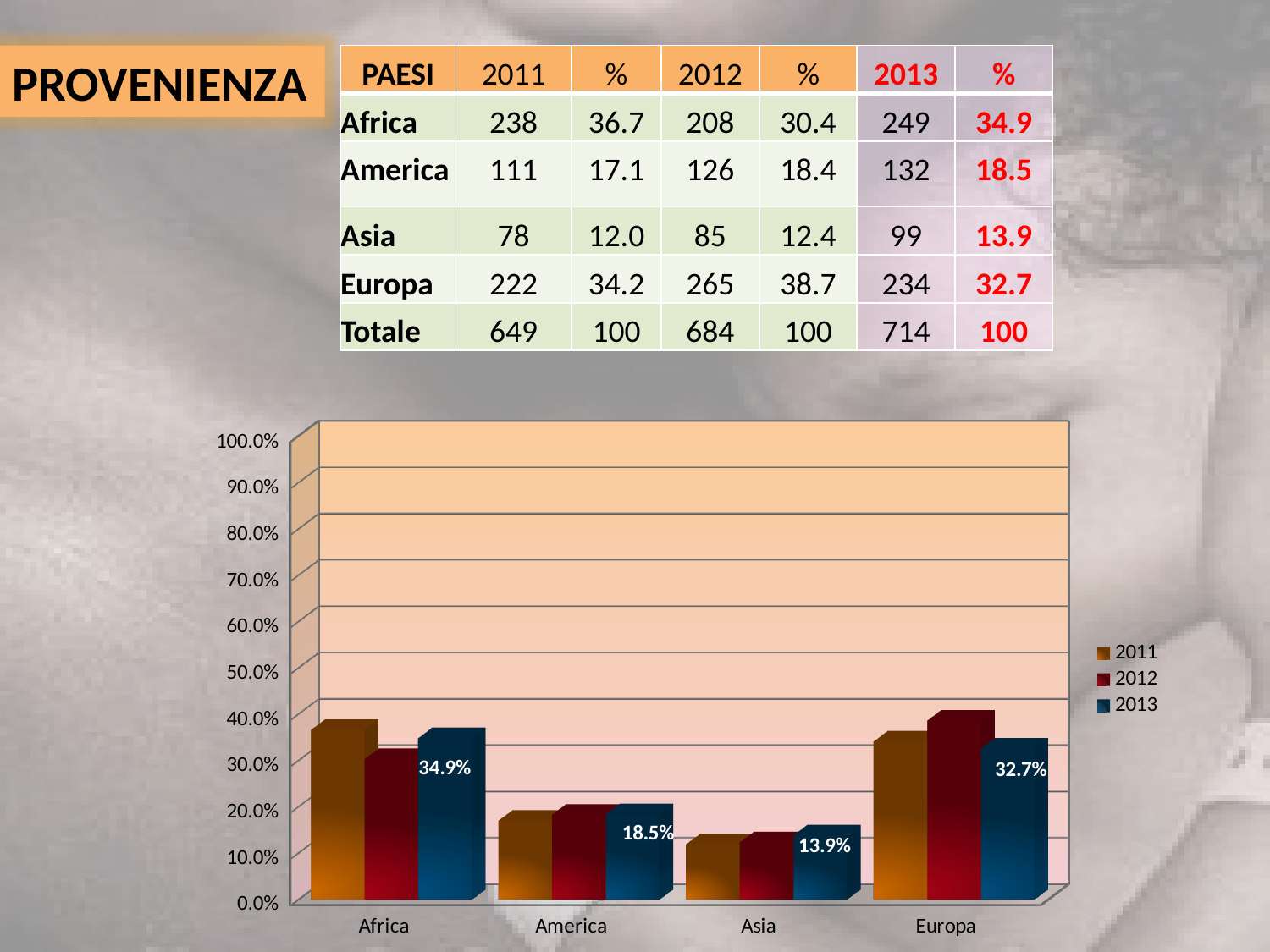
In the bar chart, what is the value for Africa in the 2013 series? 34.9% In the bar chart, what is the difference between the 2013 values for Africa and Europa? 2.2% In the bar chart, is the 2012 value for Asia greater or less than 20.0%? less How many series does the legend of the bar chart list? 3 In the bar chart, what is the value for Europa in the 2013 series? 32.7% In the bar chart, what is the value for America in the 2013 series? 18.5% In the bar chart, which is larger in the 2013 series: America or Asia? America How many categories are shown on the x axis of the bar chart? 4 In the bar chart, is the 2011 value for Africa greater or less than 30.0%? greater In the bar chart, which category has the highest value in the 2013 series? Africa In the bar chart, which category has the lowest value in the 2013 series? Asia In the bar chart, what is the value for Asia in the 2013 series? 13.9%